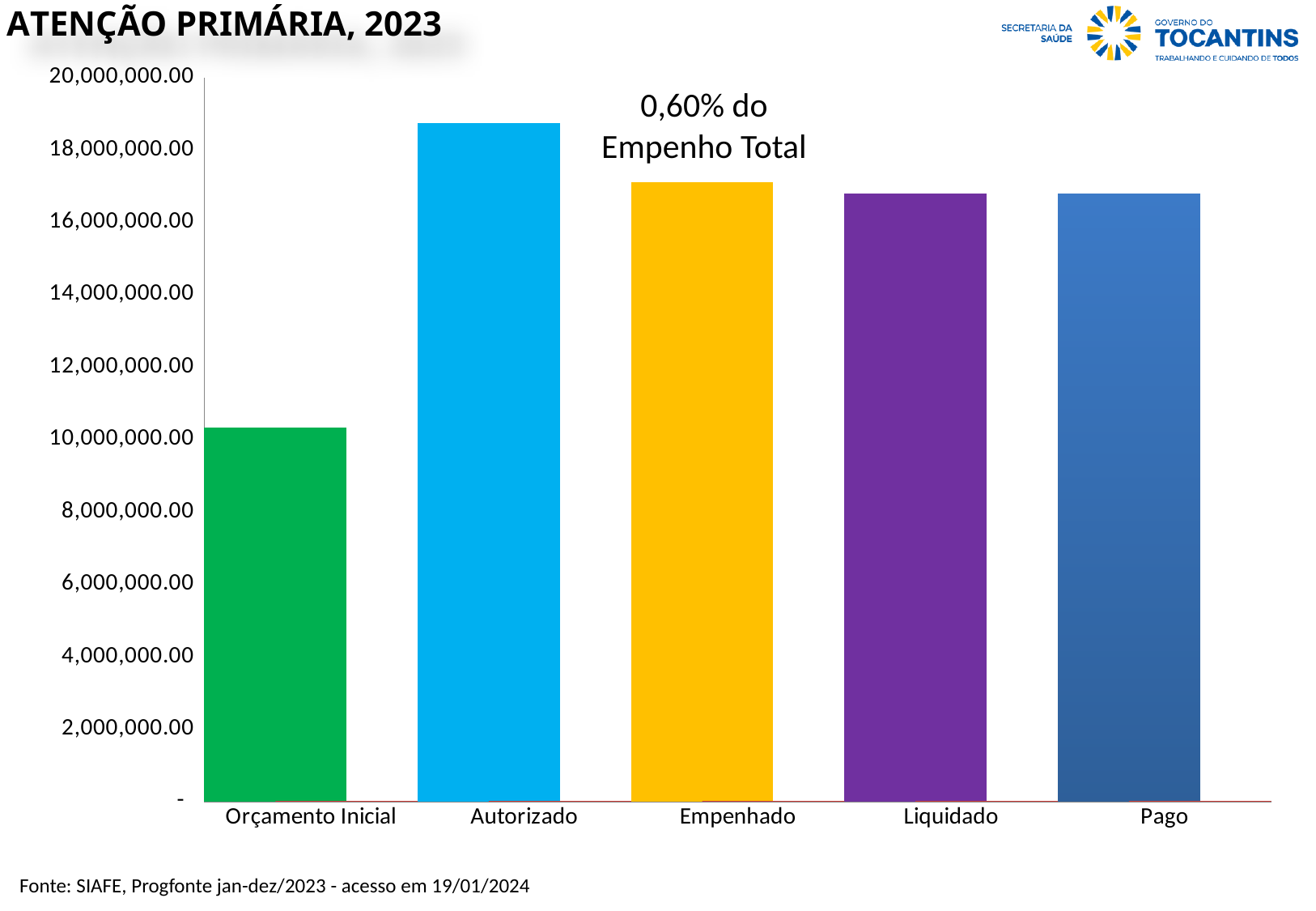
What percentage of the Empenho Total does the annotation above the Empenhado bar state? 0,60% How many categories are plotted on the x axis? 5 What kind of chart is shown on the slide? Bar chart Which category has the lowest value? Orçamento Inicial Which is larger, the value for Orçamento Inicial or the value for Liquidado? Liquidado What is the title of the chart? ATENÇÃO PRIMÁRIA, 2023 Is the value for Empenhado greater or less than 16,000,000.00? greater Which category has the highest value? Autorizado Which is larger, the value for Autorizado or the value for Empenhado? Autorizado Is the value for Autorizado greater or less than 18,000,000.00? greater Is the value for Orçamento Inicial greater or less than 12,000,000.00? less